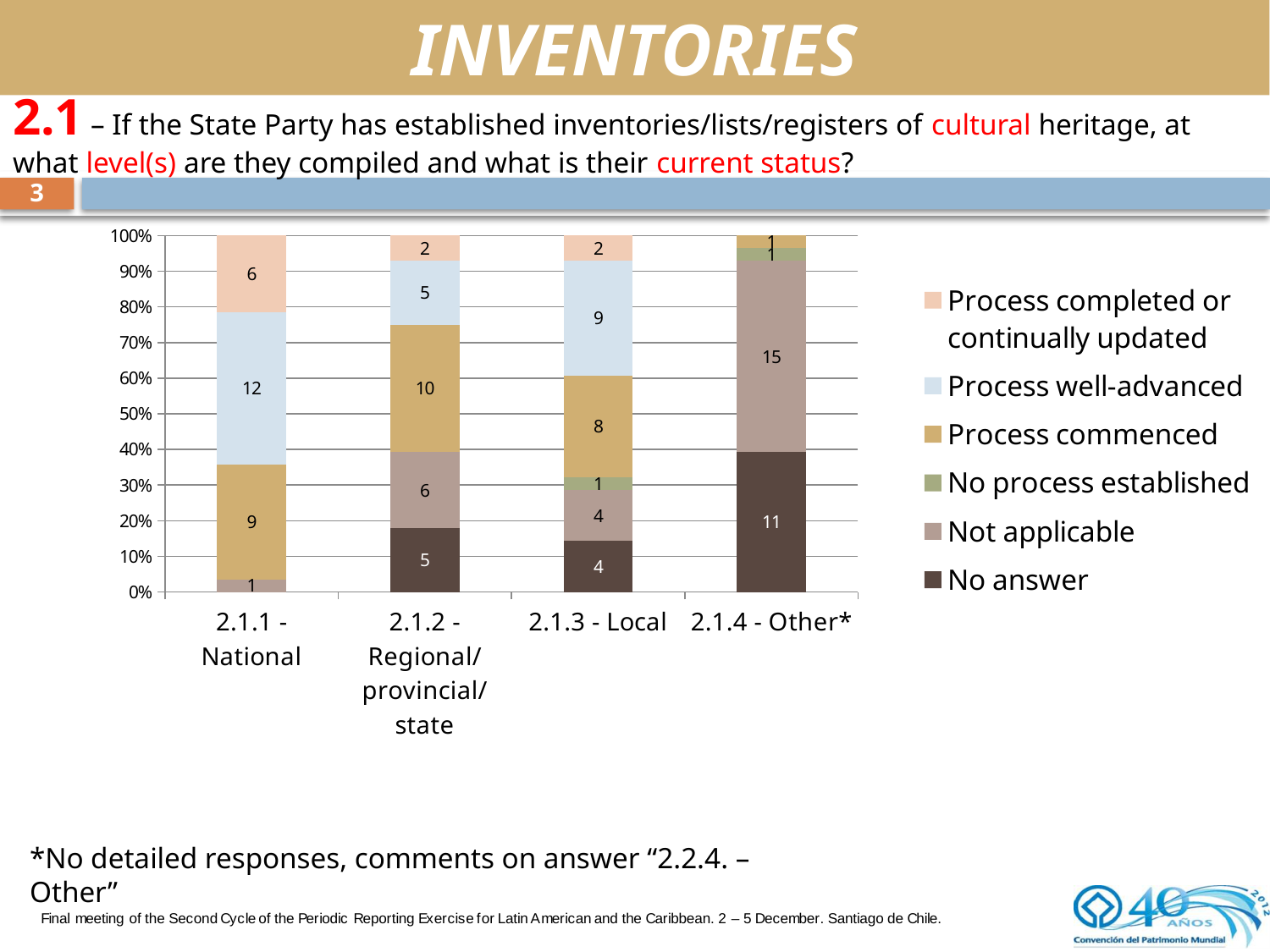
What is the value for 'Not applicable' in the 2.1.4 - Other* bar? 15 What is the difference between the 'Process well-advanced' values for 2.1.1 - National and 2.1.3 - Local? 3 How many categories are shown on the x axis? 4 What is the total of the values in the 2.1.2 - Regional/provincial/state bar? 28 What is the value for 'No answer' in the 2.1.3 - Local bar? 4 What is the value for 'Process well-advanced' in the 2.1.1 - National bar? 12 What kind of chart is shown on the slide? Stacked bar chart Which is larger: 'Process commenced' for 2.1.1 - National or for 2.1.3 - Local? 2.1.1 - National What is the value for 'Process commenced' in the 2.1.2 - Regional/provincial/state bar? 10 How many series does the legend list? 6 Which category has the highest value for 'No answer'? 2.1.4 - Other* Which category has the highest value for 'Process completed or continually updated'? 2.1.1 - National